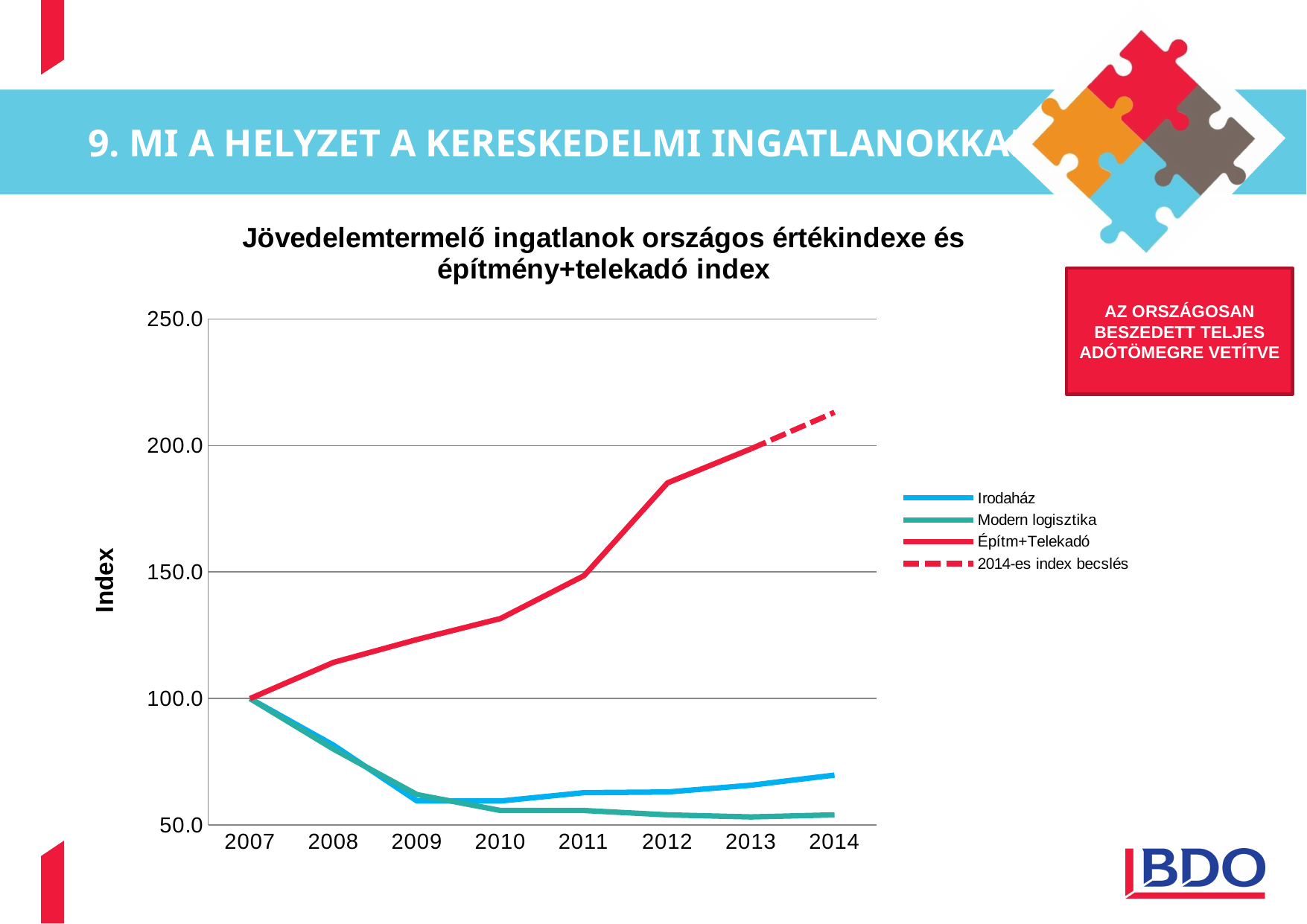
Is the value for Építm+Telekadó in 2012 greater or less than 150? greater What is the value of the Építm+Telekadó series in 2007? 100.0 Which series has the highest value in 2014? 2014-es index becslés How many entries does the chart legend list? 4 Does the Építm+Telekadó series rise or fall from 2007 to 2014? rise In 2014, which is larger: the Irodaház value or the Modern logisztika value? Irodaház What does the dashed red line in the chart represent according to the legend? 2014-es index becslés Which series has the lowest value in 2014? Modern logisztika Is the value for Irodaház in 2014 greater or less than 100? less Is the estimated 2014 value of the Építm+Telekadó index greater or less than 200? greater What kind of chart is shown on the slide? line chart How many years are shown on the x axis of the chart? 8